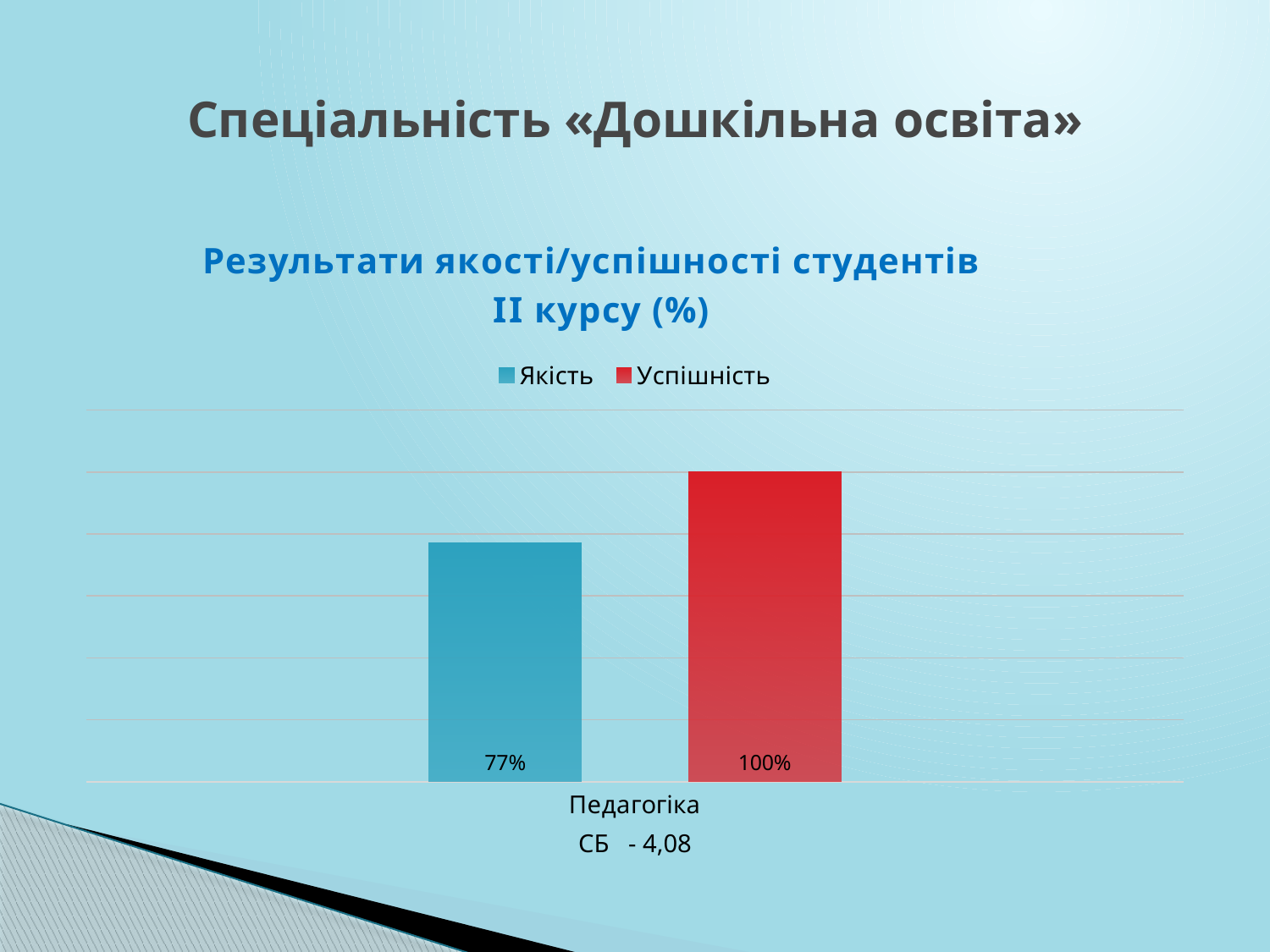
What is the difference between the Успішність and Якість values for Педагогіка? 23% Which series has the higher value for Педагогіка, Якість or Успішність? Успішність What is the title of the chart? Результати якості/успішності студентів ІІ курсу (%) What is the name of the category shown on the x axis? Педагогіка What colour is the bar for the Успішність series? Red What kind of chart is shown on the slide? Bar chart What is the value for Якість in the Педагогіка category? 77% Which series has the highest value on the chart? Успішність Which series has the lowest value on the chart? Якість How many series does the legend list? 2 What is the value for Успішність in the Педагогіка category? 100% How many categories are shown on the x axis? 1